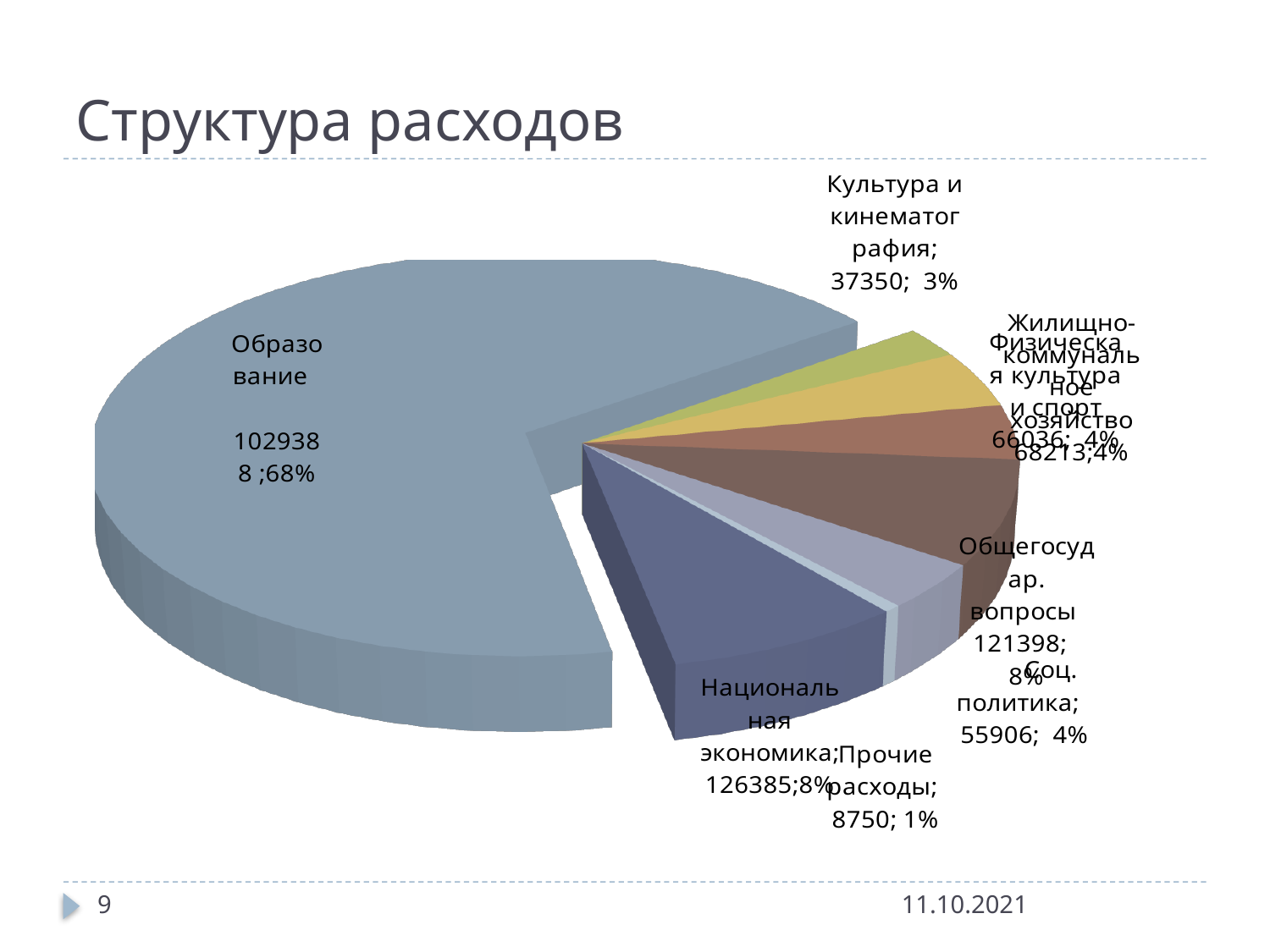
What value is shown for Образование? 1029388 What value is shown for Культура и кинематография? 37350 What value is shown for Общегосудар. вопросы? 121398 What share of the pie does Прочие расходы take? 1% What is the difference between the values for Национальная экономика and Общегосудар. вопросы? 4987 What is the title of the chart? Структура расходов Which category has the smallest slice? Прочие расходы What share of the pie does Образование take? 68% What kind of chart is shown on the slide? pie chart Which is larger, the value for Соц. политика or the value for Культура и кинематография? Соц. политика Which category has the largest slice? Образование How many slices does the pie chart have? 8